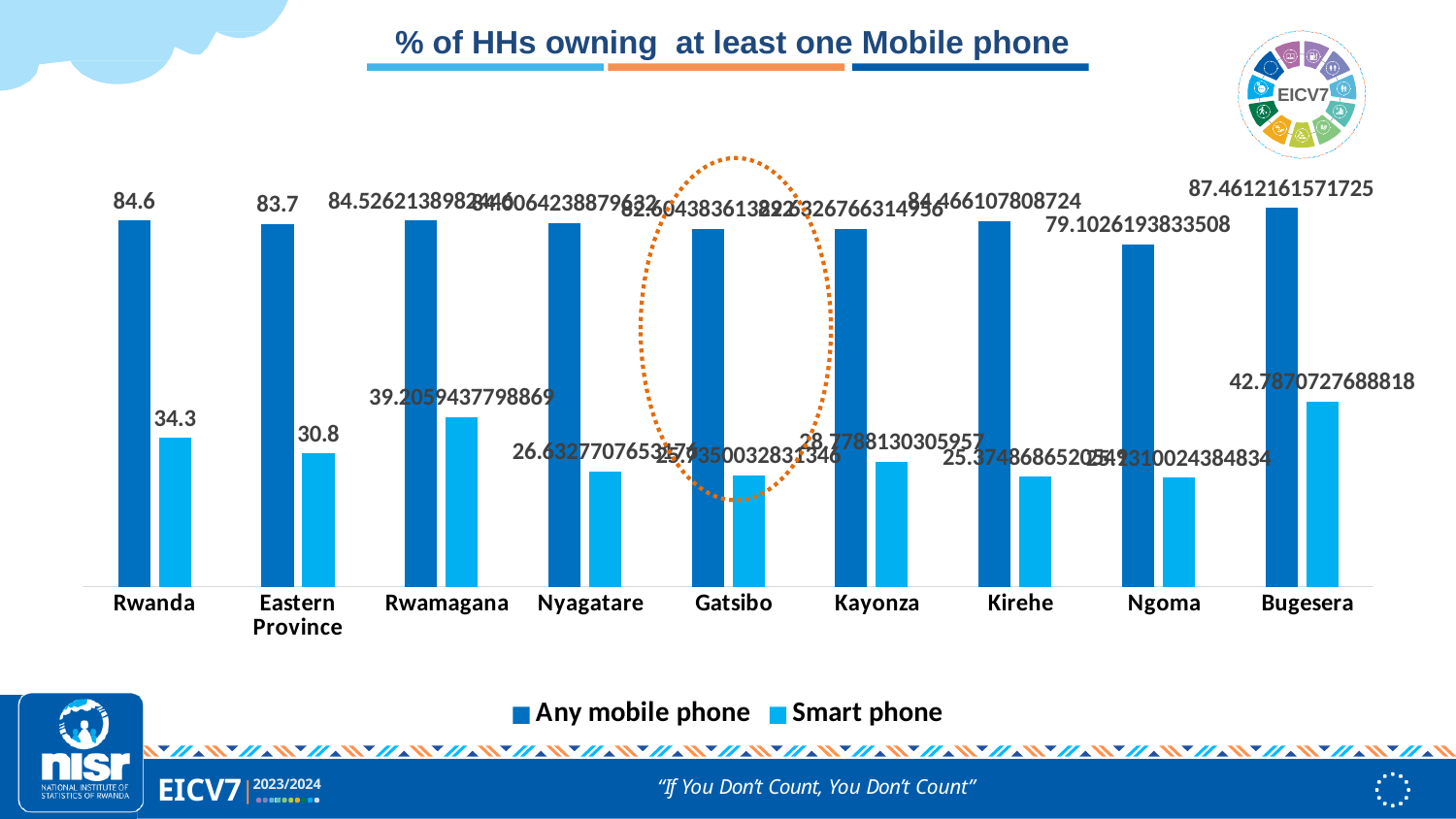
How many series does the legend list? 2 What kind of chart is shown on the slide? Bar chart What is the value for Smart phone in Rwamagana? 39.2059437798869 What is the value for Any mobile phone in Rwanda? 84.6 What is the value for Any mobile phone in Bugesera? 87.4612161571725 Which category has the lowest value for Any mobile phone? Ngoma How many categories are shown on the x axis? 9 What is the difference between the Any mobile phone and Smart phone values for Rwanda? 50.3 Which category has the highest value for Any mobile phone? Bugesera What is the value for Smart phone in Eastern Province? 30.8 Which is larger: the Smart phone value for Rwanda or for Eastern Province? Rwanda Which category has the highest value for Smart phone? Bugesera